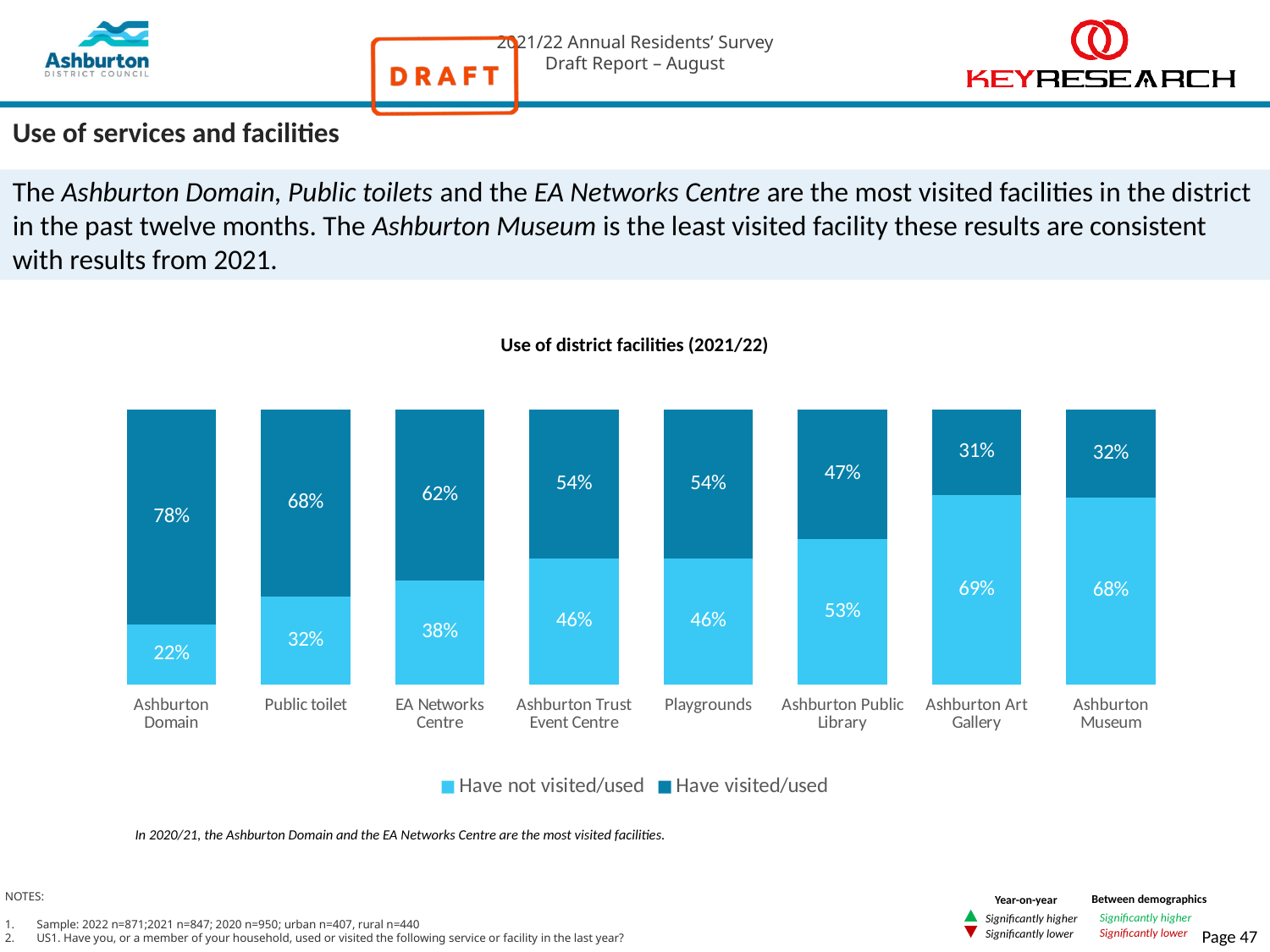
What is the title of the chart? Use of district facilities (2021/22) What is the 'Have visited/used' value for the EA Networks Centre? 62% How many series does the chart legend list? 2 Which is larger: the 'Have not visited/used' value for Playgrounds or for the Ashburton Art Gallery? Ashburton Art Gallery How many facilities are shown on the x axis of the chart? 8 Which facility has the lowest 'Have visited/used' percentage? Ashburton Art Gallery What percentage of respondents have not visited/used the Ashburton Public Library? 53% What type of chart is used to show use of district facilities? Stacked bar chart What is the total of the stacked bar for the Ashburton Trust Event Centre? 100% Which facility has the highest 'Have visited/used' percentage? Ashburton Domain What percentage of respondents have visited/used the Ashburton Domain? 78% What is the difference between the 'Have visited/used' percentages for Public toilet and the Ashburton Museum? 36%